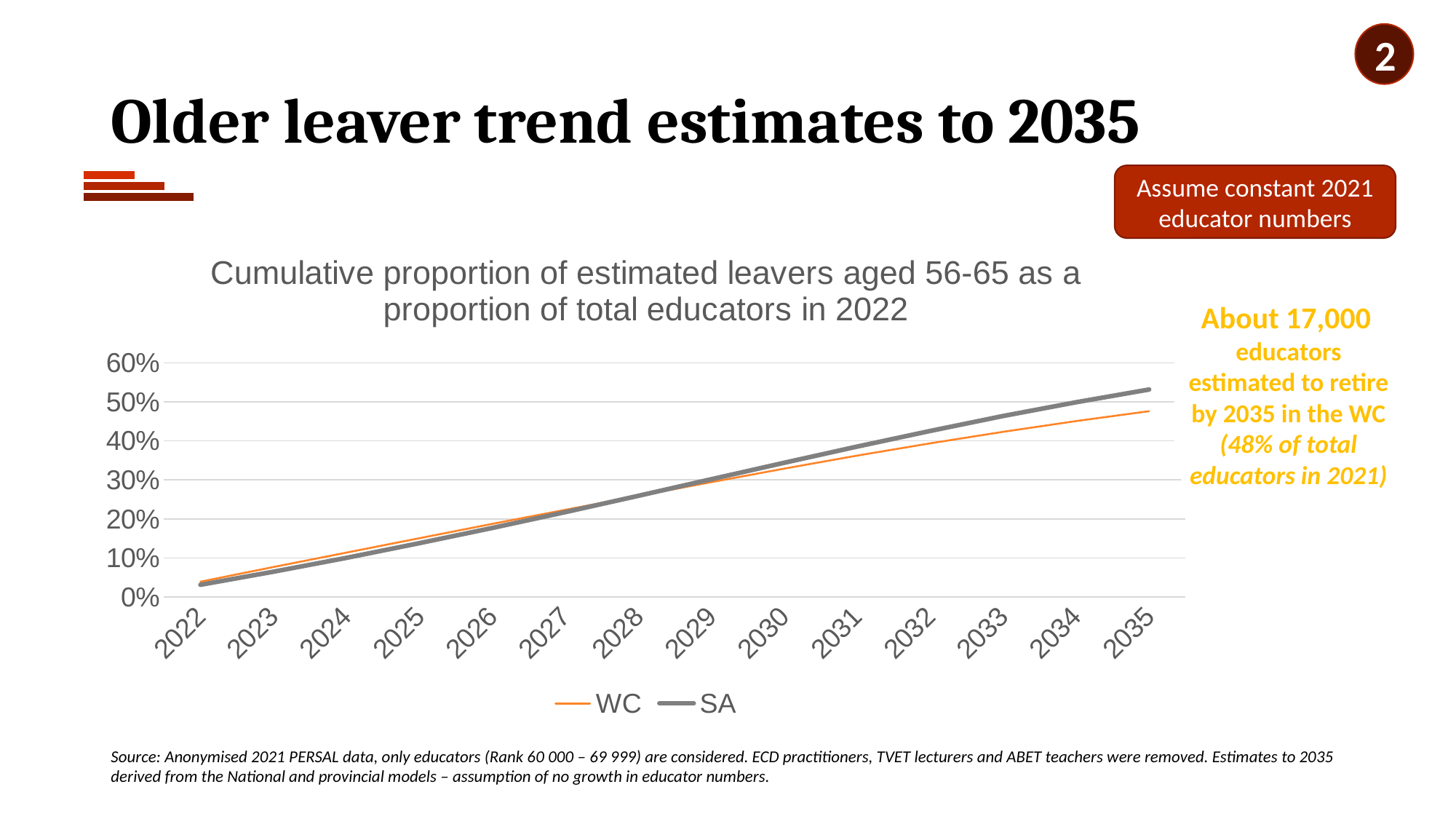
How many years are shown along the x axis? 14 How many series does the legend list? 2 Is the value for WC in 2028 greater or less than 20%? greater Which series is drawn with the orange line? WC Is the value for SA in 2035 greater or less than 50%? greater What kind of chart is shown on the slide? line chart Is the value for SA in 2022 greater or less than 10%? less In 2035, which series has the larger value, WC or SA? SA What is the title of the chart? Cumulative proportion of estimated leavers aged 56-65 as a proportion of total educators in 2022 Do the values for SA rise or fall from 2022 to 2035? rise